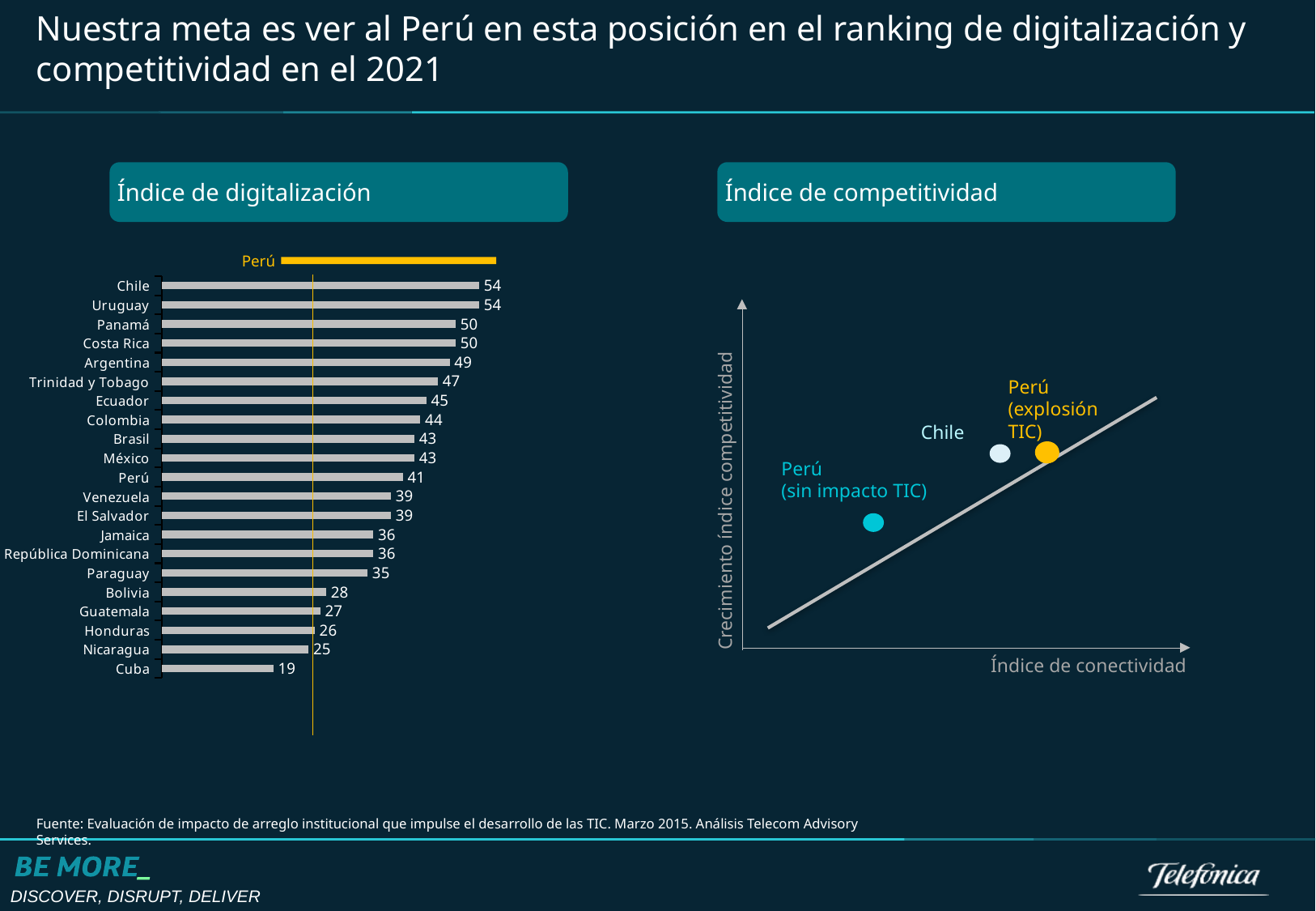
In the Índice de digitalización chart, which has a larger value, Ecuador or Venezuela? Ecuador In the Índice de digitalización chart, what is the value for Perú? 41 How many countries are listed in the Índice de digitalización chart? 21 In the Índice de digitalización chart, which country has the lowest value? Cuba In the Índice de digitalización chart, what is the value for Trinidad y Tobago? 47 What kind of chart is the Índice de digitalización chart? Bar chart In the Índice de digitalización chart, which countries share the highest value? Chile and Uruguay In the Índice de digitalización chart, what is the value for Colombia? 44 In the Índice de digitalización chart, what is the difference between the values for Chile and Perú? 13 In the Índice de competitividad chart, which point is lowest on the Crecimiento índice competitividad axis? Perú (sin impacto TIC) In the Índice de competitividad chart, what is the label of the horizontal axis? Índice de conectividad In the Índice de competitividad chart, how many data points are plotted? 3